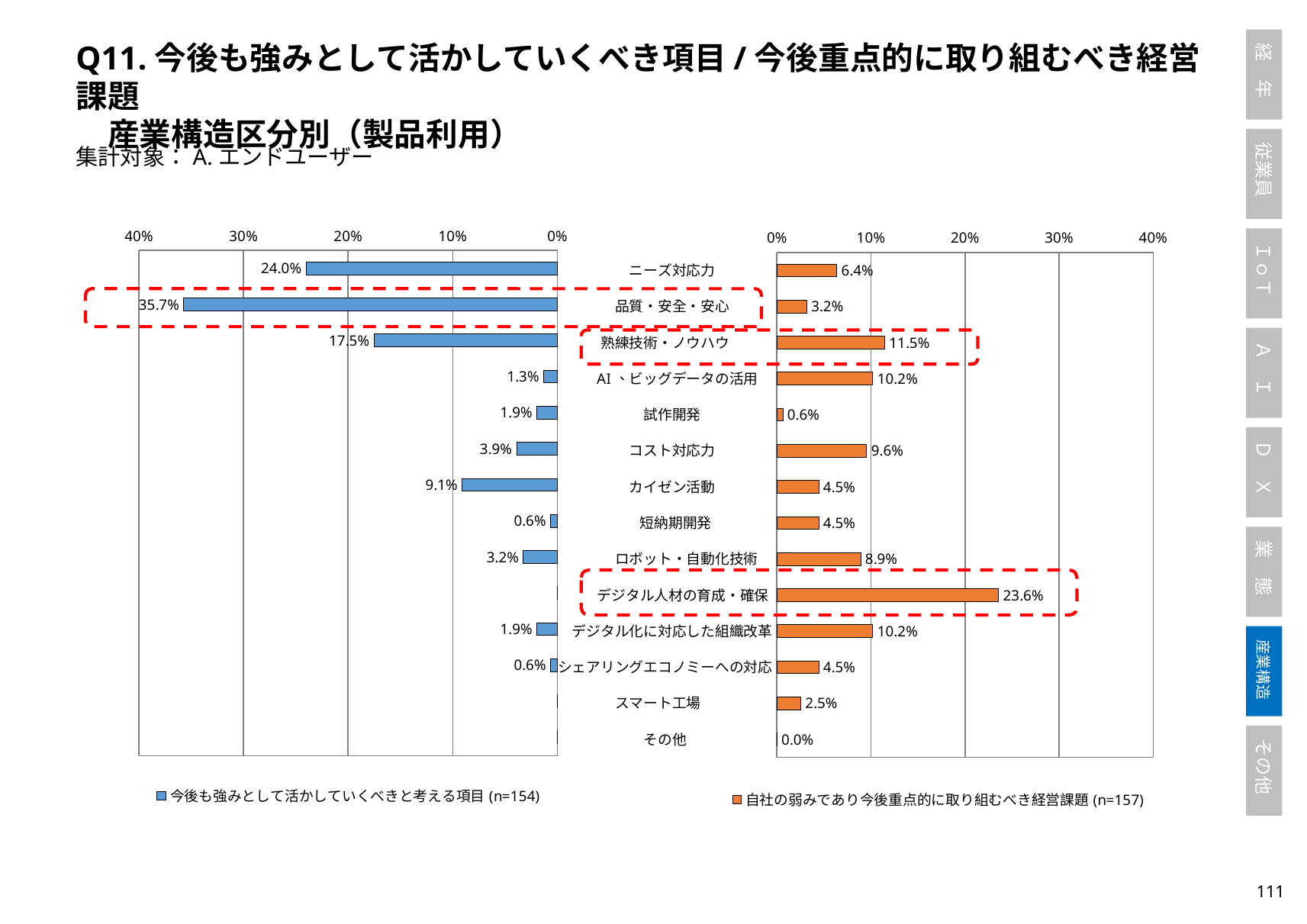
In the right chart, which category has the lowest value? その他 In the left chart, is the value for 熟練技術・ノウハウ greater or less than 10%? greater In the right chart, which category has the highest value? デジタル人材の育成・確保 What is the sample size (n) shown in the legend of the right chart? n=157 In the left chart, what is the difference between the values for 品質・安全・安心 and ニーズ対応力? 11.7% In the left chart (今後も強みとして活かしていくべきと考える項目), what is the value for 品質・安全・安心? 35.7% In the left chart, which category has the highest value? 品質・安全・安心 In the right chart (自社の弱みであり今後重点的に取り組むべき経営課題), what is the value for デジタル人材の育成・確保? 23.6% What type of chart is used on the slide? Bar chart In the right chart, what is the value for 熟練技術・ノウハウ? 11.5% In the right chart, which is larger: the value for コスト対応力 or the value for ロボット・自動化技術? コスト対応力 How many categories are listed on the slide's charts? 14